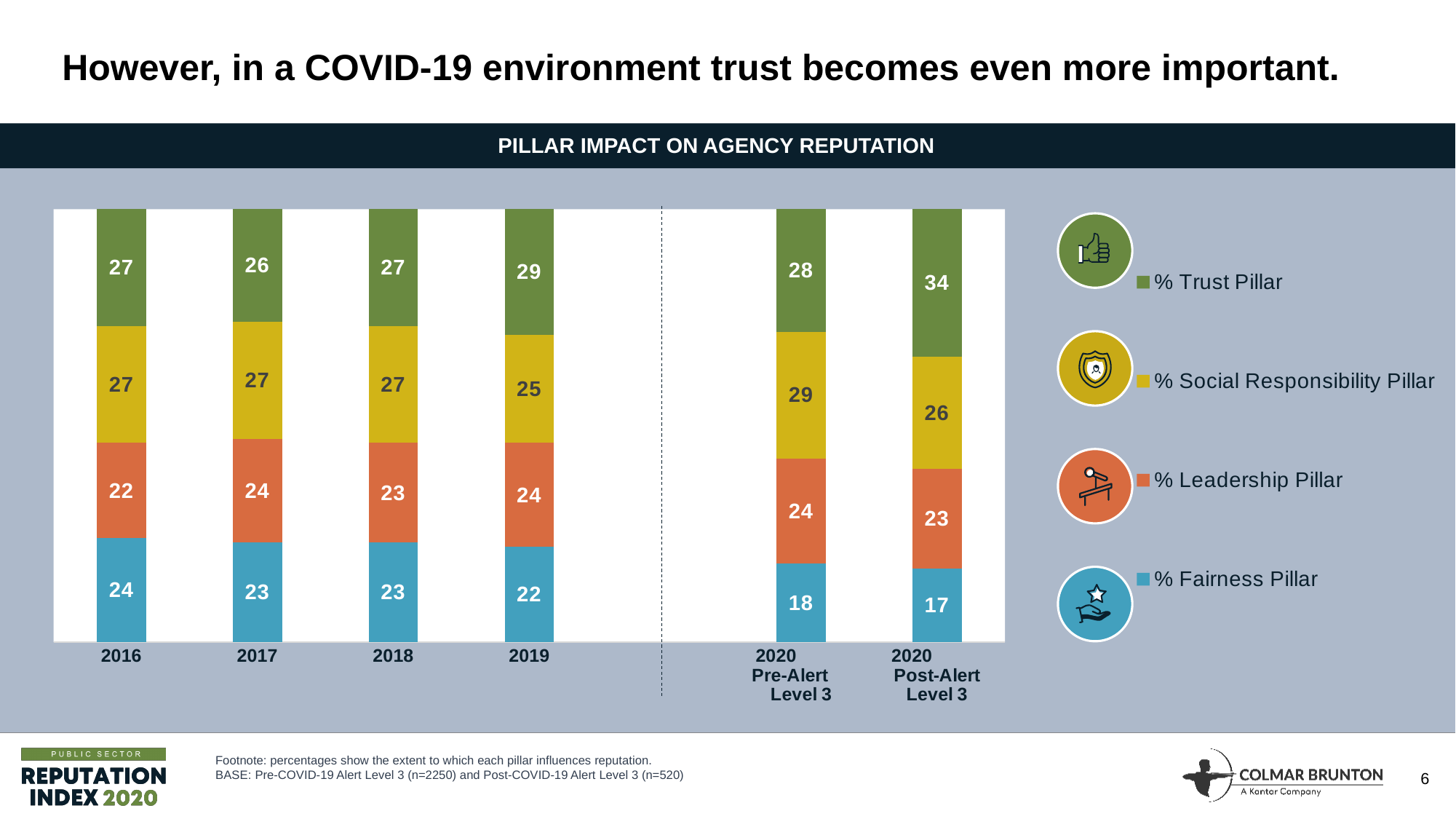
Which category has the lowest % Fairness Pillar value? 2020 Post-Alert Level 3 What is the difference between the % Trust Pillar values for 2020 Post-Alert Level 3 and 2020 Pre-Alert Level 3? 6 What is the % Social Responsibility Pillar value for 2019? 25 What is the % Leadership Pillar value for 2020 Pre-Alert Level 3? 24 How many categories are shown on the x axis? 6 What kind of chart is shown? Stacked bar chart What is the % Trust Pillar value for 2020 Post-Alert Level 3? 34 Which category has the highest % Trust Pillar value? 2020 Post-Alert Level 3 What is the title of the chart? PILLAR IMPACT ON AGENCY REPUTATION What is the % Fairness Pillar value for 2016? 24 How many series does the legend list? 4 Which is larger: the % Fairness Pillar value for 2016 or for 2020 Pre-Alert Level 3? 2016